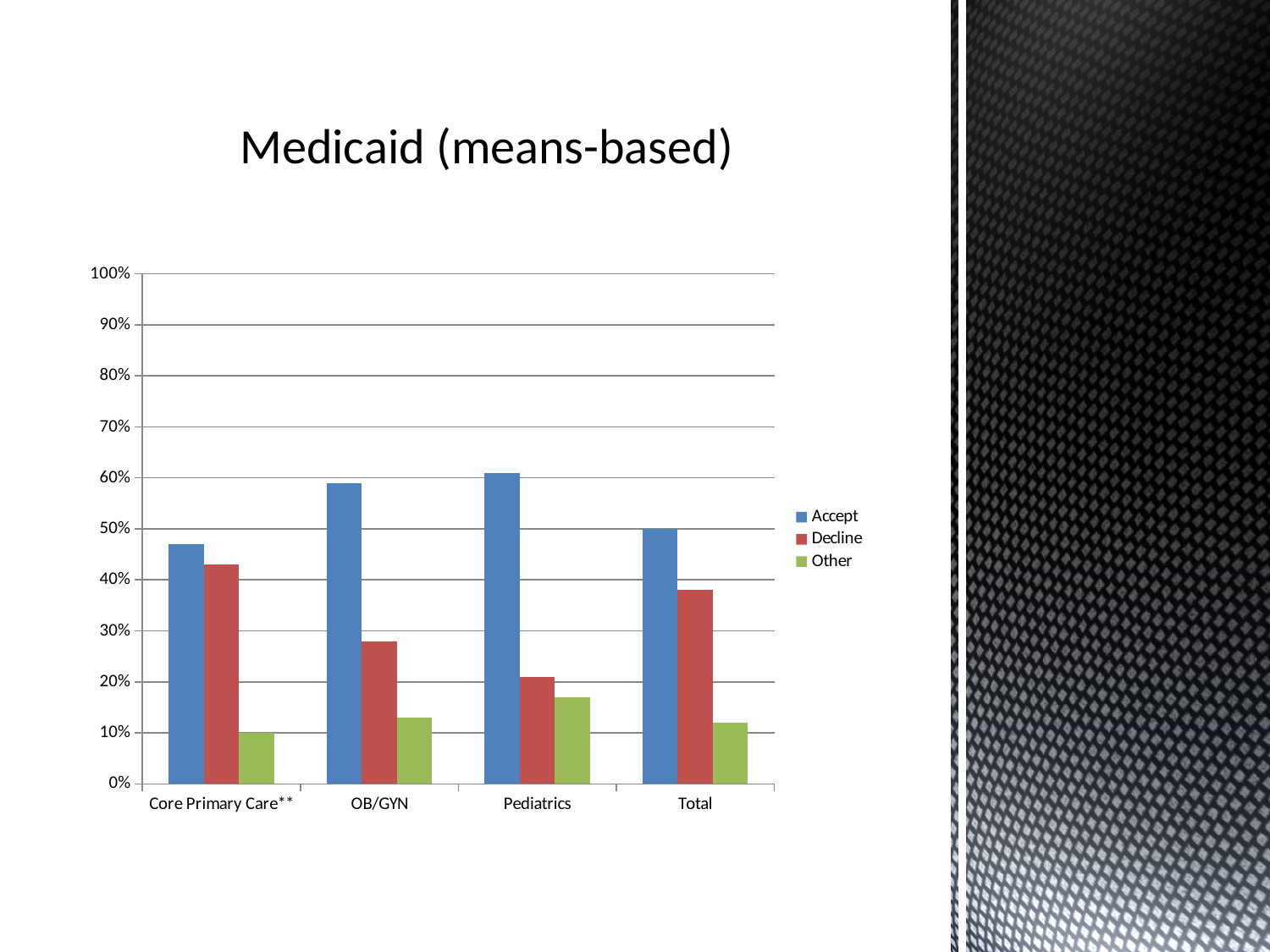
Which category has the lowest Other value? Core Primary Care** What is the title of the chart? Medicaid (means-based) Which is larger, the Decline value for Core Primary Care** or the Decline value for OB/GYN? Core Primary Care** Which category has the lowest Decline value? Pediatrics How many categories are shown on the x axis? 4 How many series does the legend list? 3 Is the Accept value for OB/GYN greater or less than 50%? greater What type of chart is shown on the slide? bar chart Is the Decline value for Pediatrics greater or less than 30%? less Which is larger for Core Primary Care**, the Accept value or the Other value? Accept Which category has the highest Accept value? Pediatrics Which series is shown in green in the legend? Other